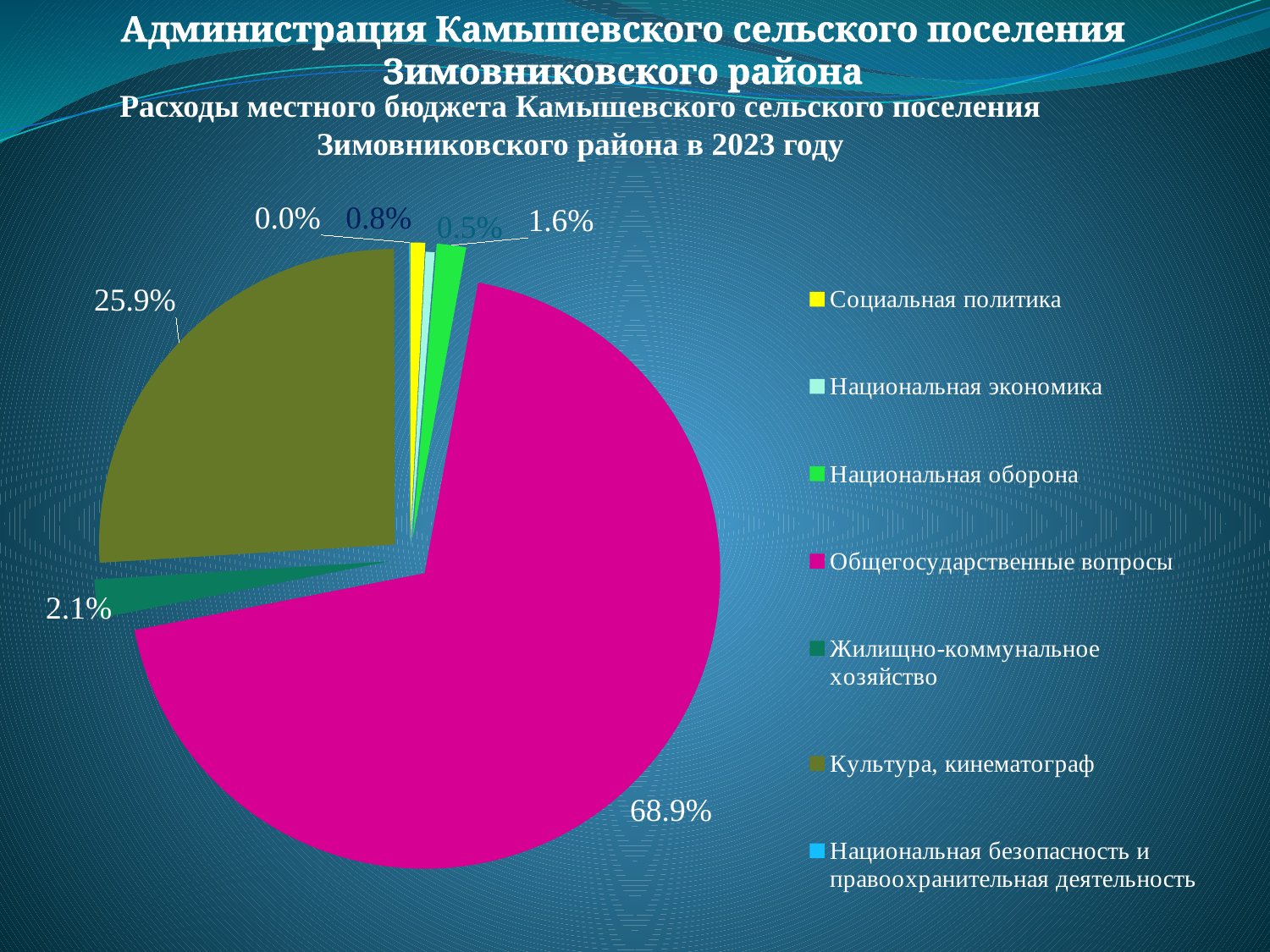
Which is larger: the share for Национальная оборона or the share for Социальная политика? Национальная оборона What share of the budget expenses goes to Жилищно-коммунальное хозяйство? 2.1% What is the difference in percentage points between Общегосударственные вопросы and Культура, кинематограф? 43.0% What share of the budget expenses goes to Общегосударственные вопросы? 68.9% What kind of chart is shown on the slide? Pie chart What share of the budget expenses goes to Социальная политика? 0.8% What share of the budget expenses goes to Культура, кинематограф? 25.9% What share of the budget expenses goes to Национальная оборона? 1.6% Which category has the largest share of the pie? Общегосударственные вопросы Which category has the smallest share of the pie? Национальная безопасность и правоохранительная деятельность How many categories does the legend list? 7 What share of the budget expenses goes to Национальная экономика? 0.5%